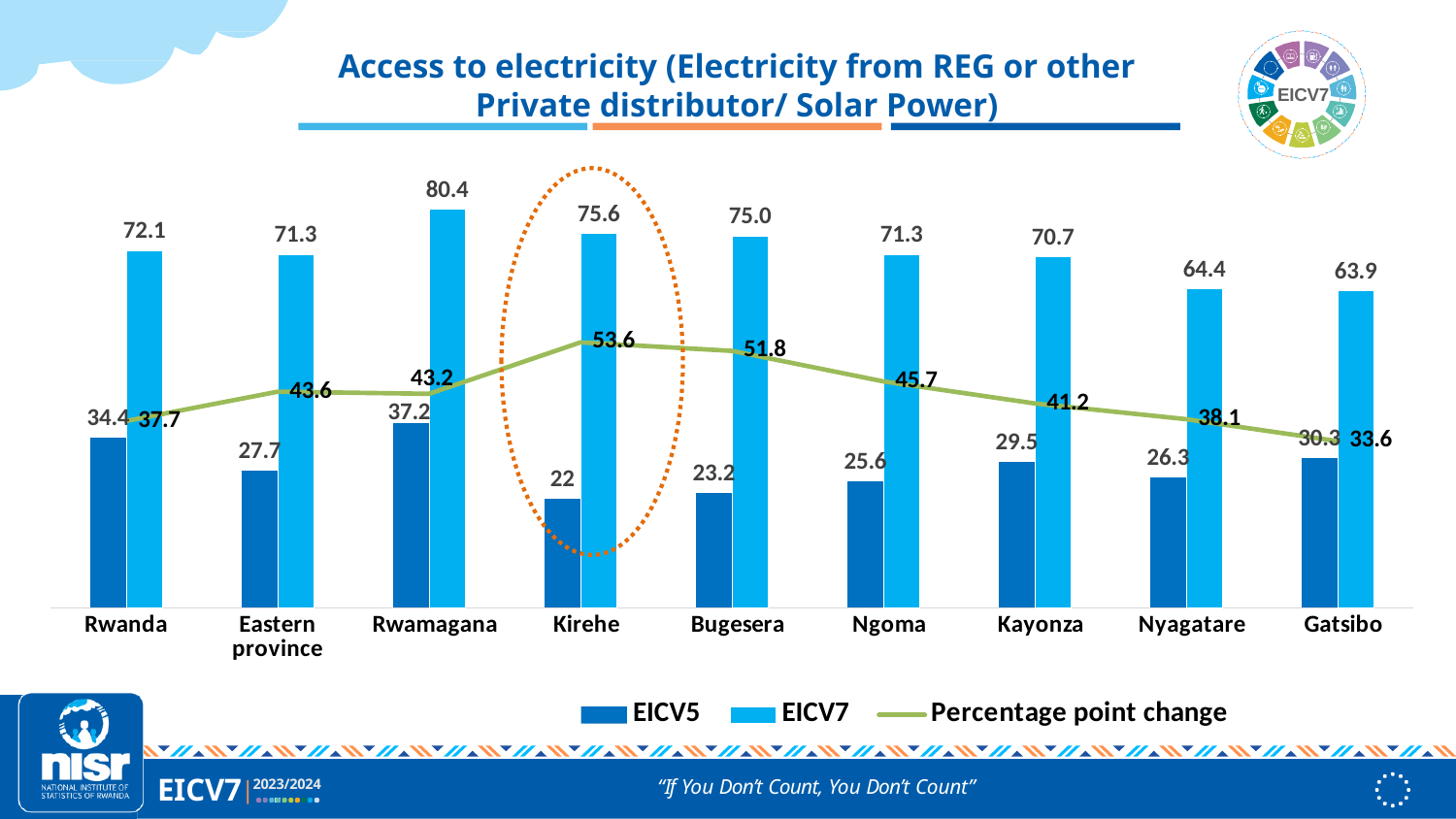
What is the percentage point change shown for Kirehe? 53.6 What is the EICV5 value for Kirehe? 22 Which category has the lowest EICV5 value? Kirehe Which category has the highest EICV7 value? Rwamagana Which has the larger EICV5 value, Rwanda or Gatsibo? Rwanda What is the EICV7 value for Rwamagana? 80.4 What is the difference between the EICV7 and EICV5 values for Bugesera? 51.8 Which category has the lowest percentage point change? Gatsibo How many series does the legend list? 3 Does the percentage point change line rise or fall from Kirehe to Gatsibo? Fall How many categories are shown on the x axis? 9 Which category has the highest percentage point change? Kirehe